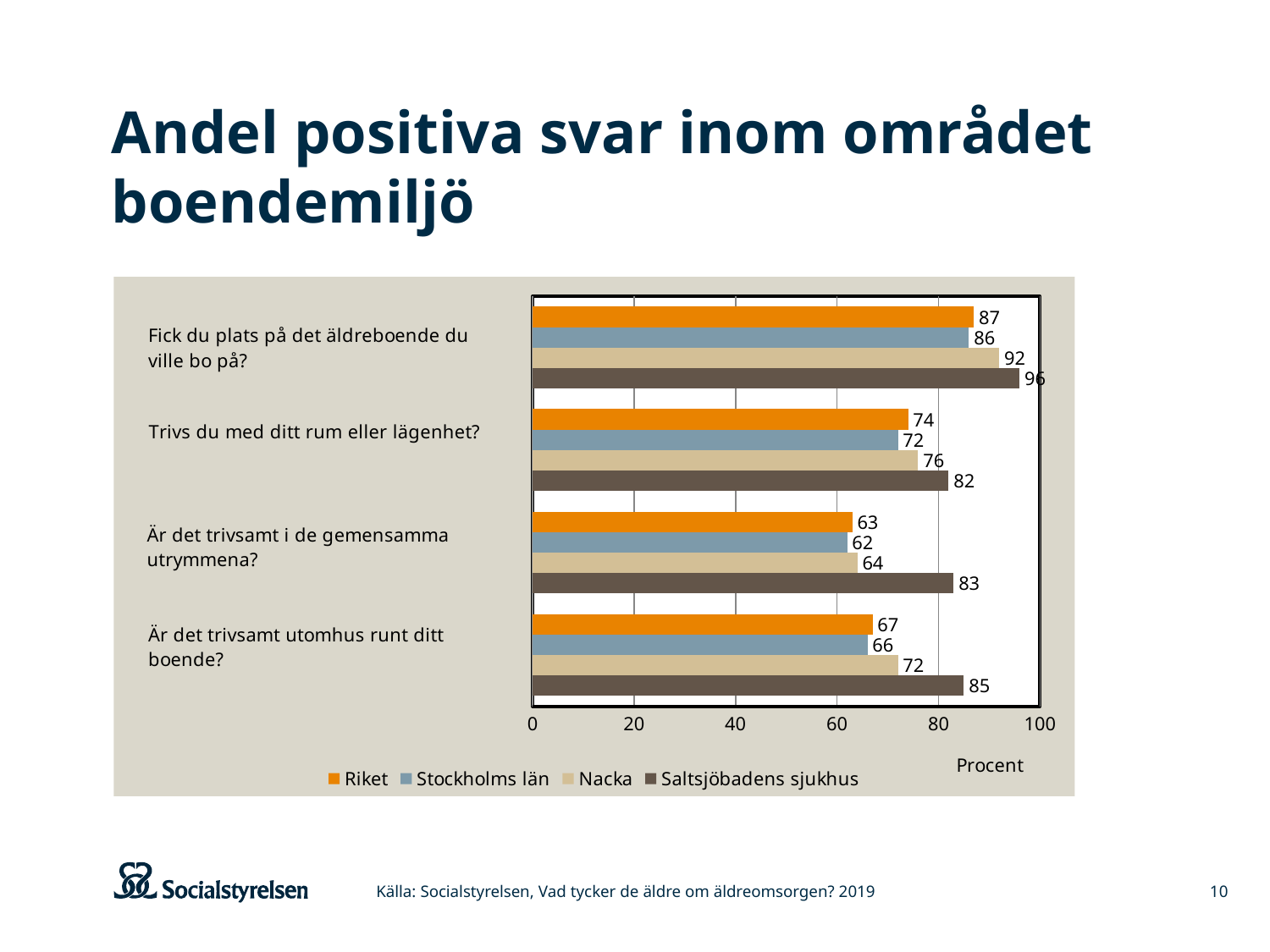
What is the value for Riket on "Är det trivsamt utomhus runt ditt boende?"? 67 Which series has the highest value on "Är det trivsamt i de gemensamma utrymmena?"? Saltsjöbadens sjukhus What is the value for Nacka on "Fick du plats på det äldreboende du ville bo på?"? 92 What is the difference between Saltsjöbadens sjukhus and Riket on "Är det trivsamt i de gemensamma utrymmena?"? 20 What is the value for Stockholms län on "Är det trivsamt i de gemensamma utrymmena?"? 62 Which series has the lowest value on "Är det trivsamt utomhus runt ditt boende?"? Stockholms län How many questions (categories) are shown on the chart? 4 What kind of chart is shown on the slide? Bar chart Which is larger on "Trivs du med ditt rum eller lägenhet?": Nacka or Stockholms län? Nacka What is the value for Saltsjöbadens sjukhus on "Trivs du med ditt rum eller lägenhet?"? 82 How many series does the legend list? 4 Is the value for Saltsjöbadens sjukhus on "Fick du plats på det äldreboende du ville bo på?" greater or less than 80? greater